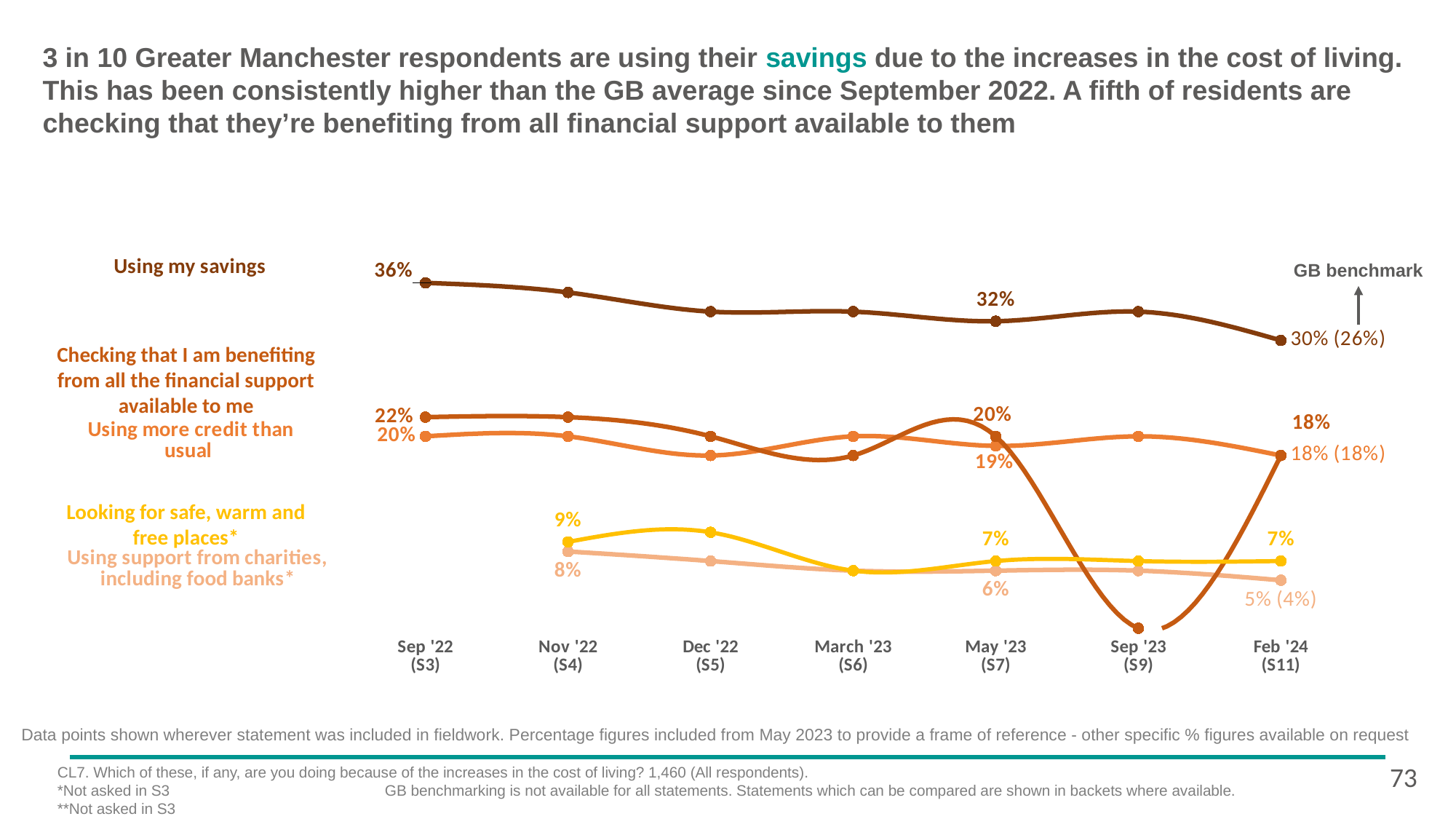
What was the value for 'Using my savings' in Sep '22 (S3)? 36% What was the value for 'Using my savings' in Feb '24 (S11)? 30% How many time points are shown on the x axis? 7 Does the 'Using my savings' line generally rise or fall from Sep '22 to Feb '24? fall What type of chart is shown on the slide? line chart Which statement has the highest value in Feb '24 (S11)? Using my savings What is the GB benchmark shown in brackets for 'Using my savings' in Feb '24? 26% What was the value for 'Using support from charities, including food banks' in Feb '24 (S11)? 5% In Nov '22, which was higher: 'Looking for safe, warm and free places' or 'Using support from charities, including food banks'? Looking for safe, warm and free places Which statement has the lowest value in Feb '24 (S11)? Using support from charities, including food banks By how many percentage points did 'Using my savings' fall between Sep '22 and Feb '24? 6 percentage points What was the value for 'Using more credit than usual' in May '23 (S7)? 19%